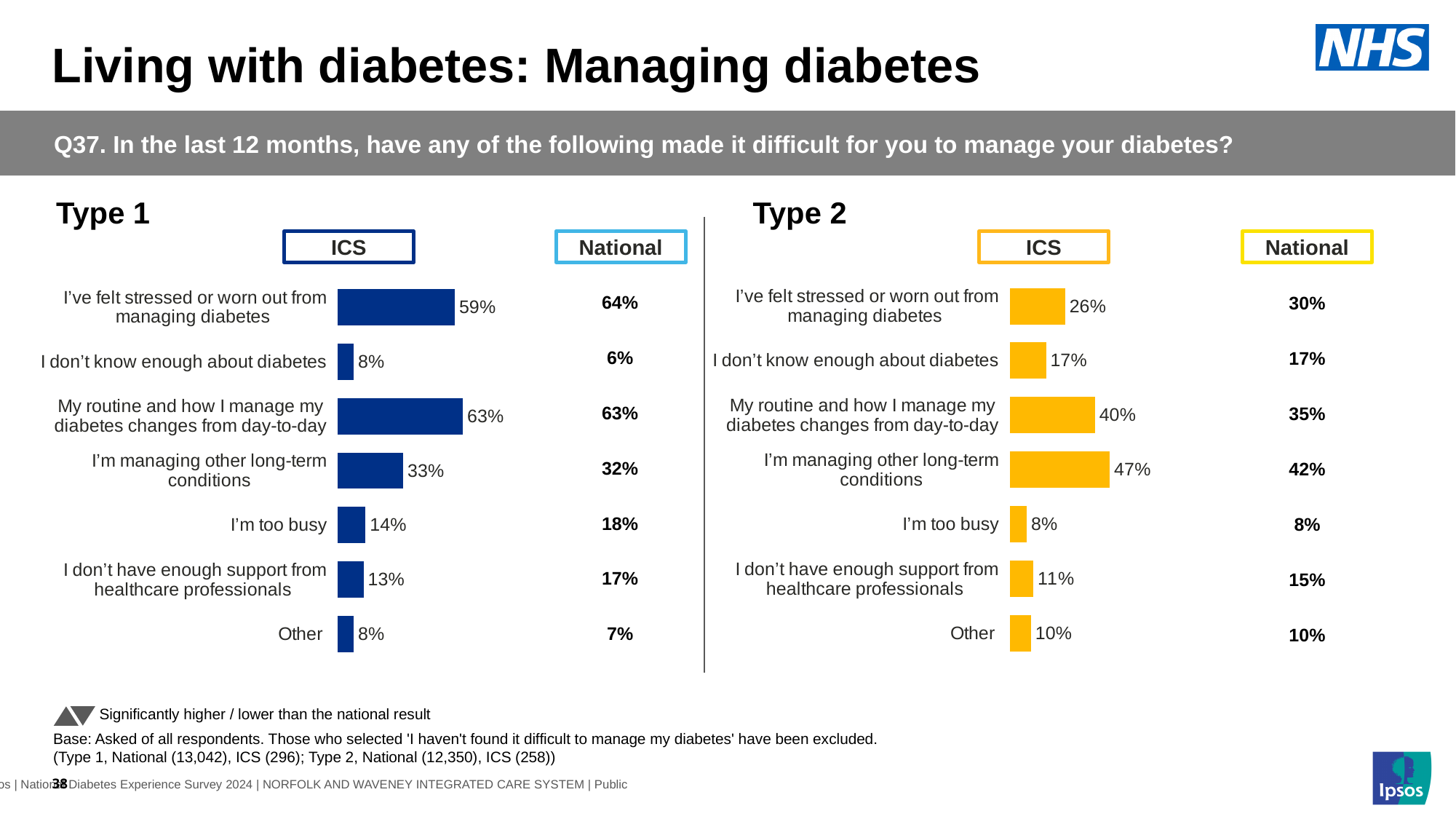
In the Type 2 chart, what is the ICS value for 'I'm managing other long-term conditions'? 47% In the Type 2 chart, which category has the highest ICS value? I'm managing other long-term conditions In the Type 1 chart, what is the National value for 'I'm too busy'? 18% In the Type 1 chart, which category has the highest ICS value? My routine and how I manage my diabetes changes from day-to-day In the Type 1 chart, what is the difference between the ICS and National values for 'I've felt stressed or worn out from managing diabetes'? 5% In the Type 1 chart, what is the ICS value for 'I've felt stressed or worn out from managing diabetes'? 59% What kind of chart is used for the Type 1 ICS results? bar chart In the Type 2 chart, which category has the lowest ICS value? I'm too busy How many categories are shown in the Type 2 chart? 7 What colour are the bars in the Type 2 chart? yellow In the Type 2 chart, what is the difference between the ICS and National values for 'My routine and how I manage my diabetes changes from day-to-day'? 5% In the Type 1 chart, is the ICS value for 'I'm managing other long-term conditions' larger or smaller than the National value? larger